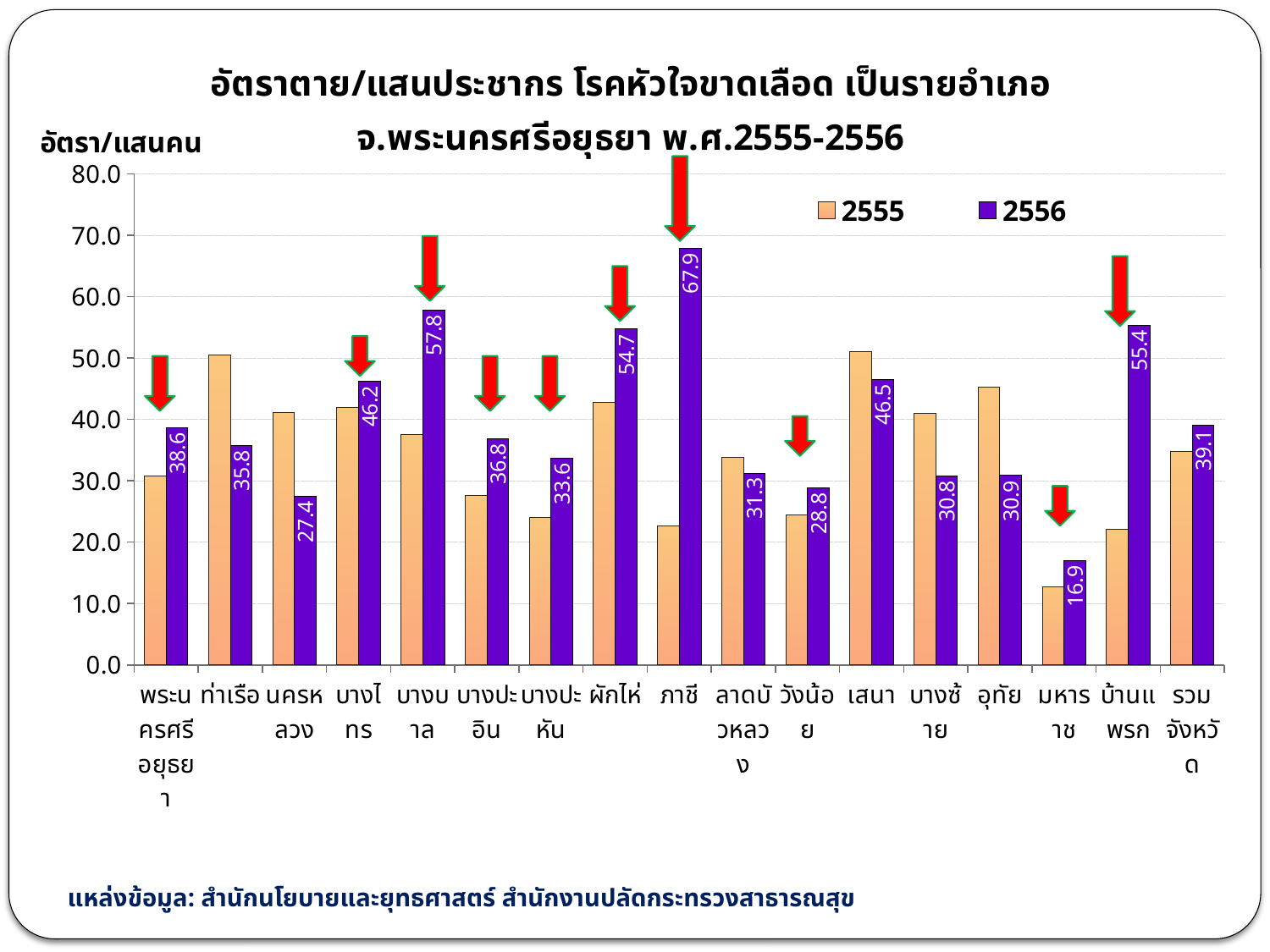
What is the 2556 value for บางบาล? 57.8 What is the 2556 value for มหาราช? 16.9 What kind of chart is shown on the slide? bar chart Is the 2555 value for ภาชี greater or less than 30.0? less How many districts (categories) are shown on the x axis? 17 What is the difference between the 2556 values for ภาชี and มหาราช? 51.0 Which district has the highest 2556 value? ภาชี Which is larger, the 2556 value for บางบาล or for ผักไห่? บางบาล How many series does the legend list? 2 Which district has the lowest 2556 value? มหาราช What is the 2556 value for ภาชี? 67.9 What is the 2556 value for รวมจังหวัด? 39.1